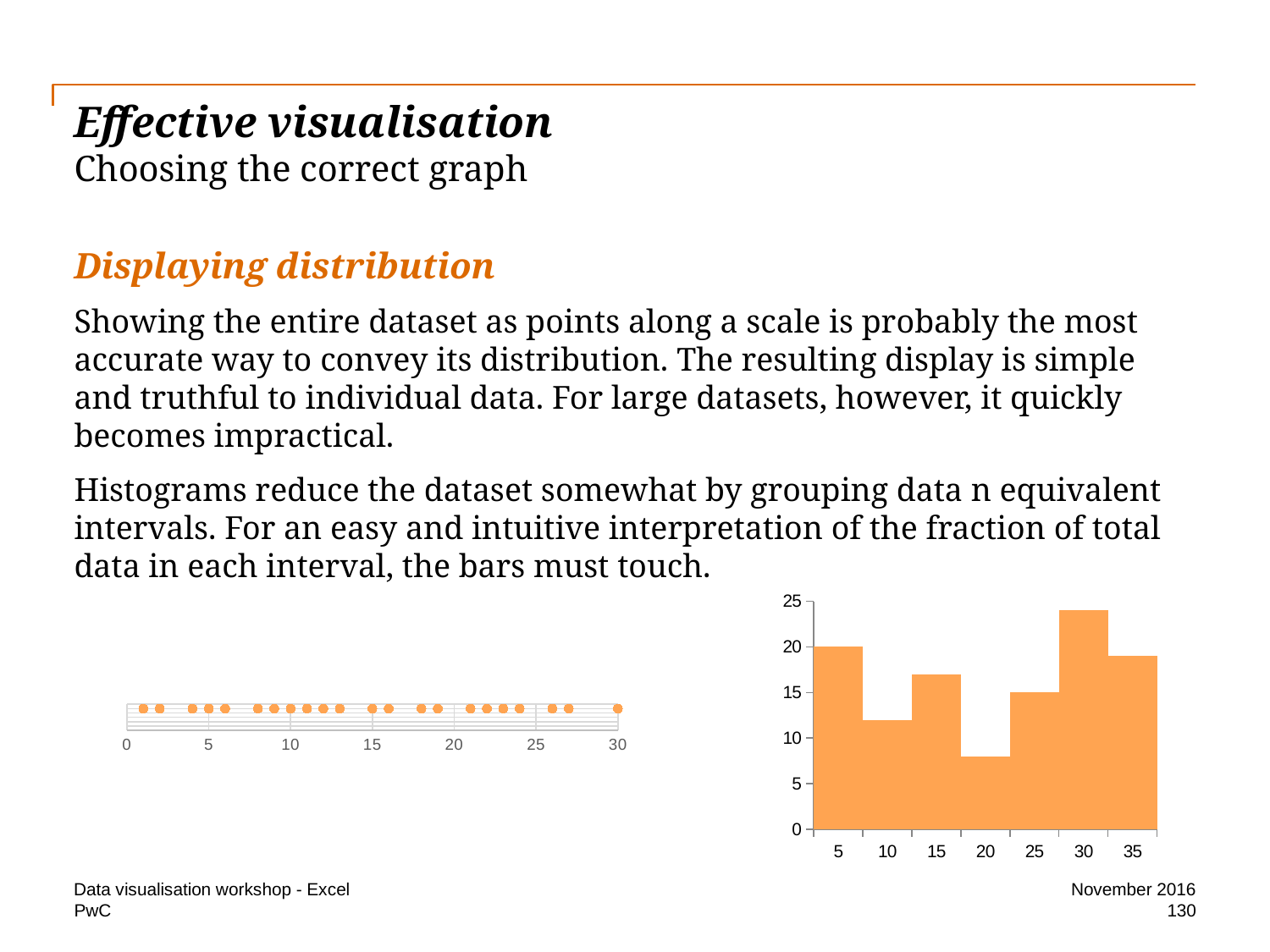
On the histogram on the right, what is the value of the bar at 25? 15 On the histogram on the right, is the bar at 15 greater or less than 15? greater On the histogram on the right, is the bar at 20 greater or less than 10? less On the histogram on the right, which bar is taller, the one at 5 or the one at 10? 5 How many bars does the histogram on the right have? 7 On the histogram on the right, is the bar at 10 greater or less than 15? less On the histogram on the right, which x-axis bin has the shortest bar? 20 What is the highest value labelled on the x axis of the dot chart on the left? 30 What kind of chart is shown on the right of the slide? bar chart (histogram) On the histogram on the right, which x-axis bin has the tallest bar? 30 On the histogram on the right, what is the value of the bar at 5? 20